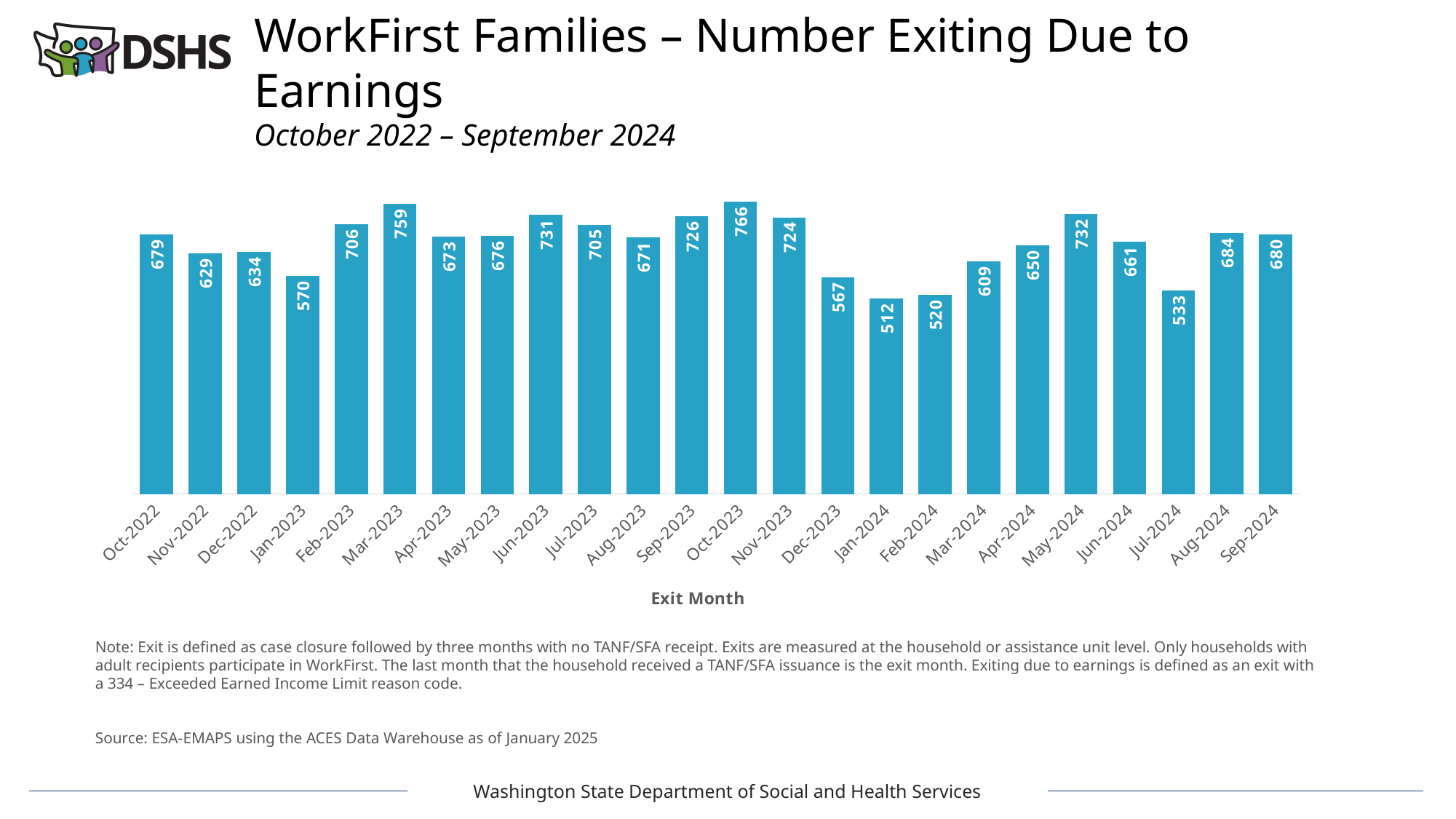
What is the label of the x axis? Exit Month What is the value shown for Jan-2024? 512 What is the value shown for Sep-2024? 680 Which is larger, the value for Feb-2023 or the value for Jul-2023? Feb-2023 What kind of chart is shown on the slide? Bar chart Which exit month has the lowest number of families exiting due to earnings? Jan-2024 Which exit month has the highest number of families exiting due to earnings? Oct-2023 What is the difference between the values for May-2024 and Jul-2024? 199 What is the number of WorkFirst families exiting due to earnings in Oct-2023? 766 What is the value shown for Mar-2023? 759 What is the difference between the values for Oct-2023 and Jan-2024? 254 How many exit months are plotted on the chart? 24